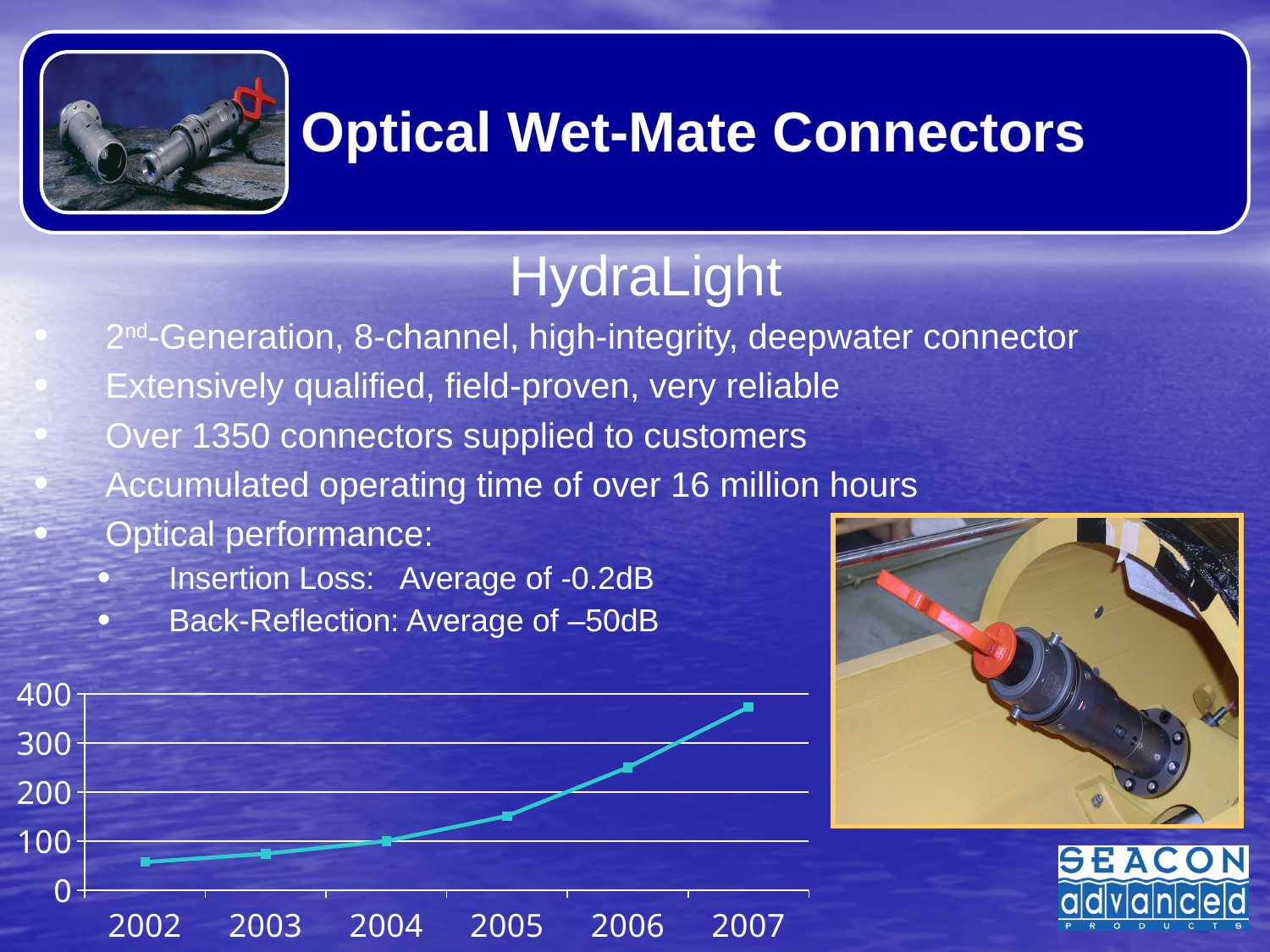
What is the highest tick value shown on the y axis of the line chart? 400 Do the values in the line chart rise or fall from 2002 to 2007? rise Which year has the highest value in the line chart? 2007 In the line chart, which year has the larger value, 2006 or 2004? 2006 What is the first year shown on the x axis of the line chart? 2002 Is the value for 2006 in the line chart greater or less than 200? greater Is the value for 2007 in the line chart greater or less than 300? greater What kind of chart is shown at the bottom left of the slide? line chart Which year has the lowest value in the line chart? 2002 How many years are shown on the x axis of the line chart? 6 Is the value for 2002 in the line chart greater or less than 100? less